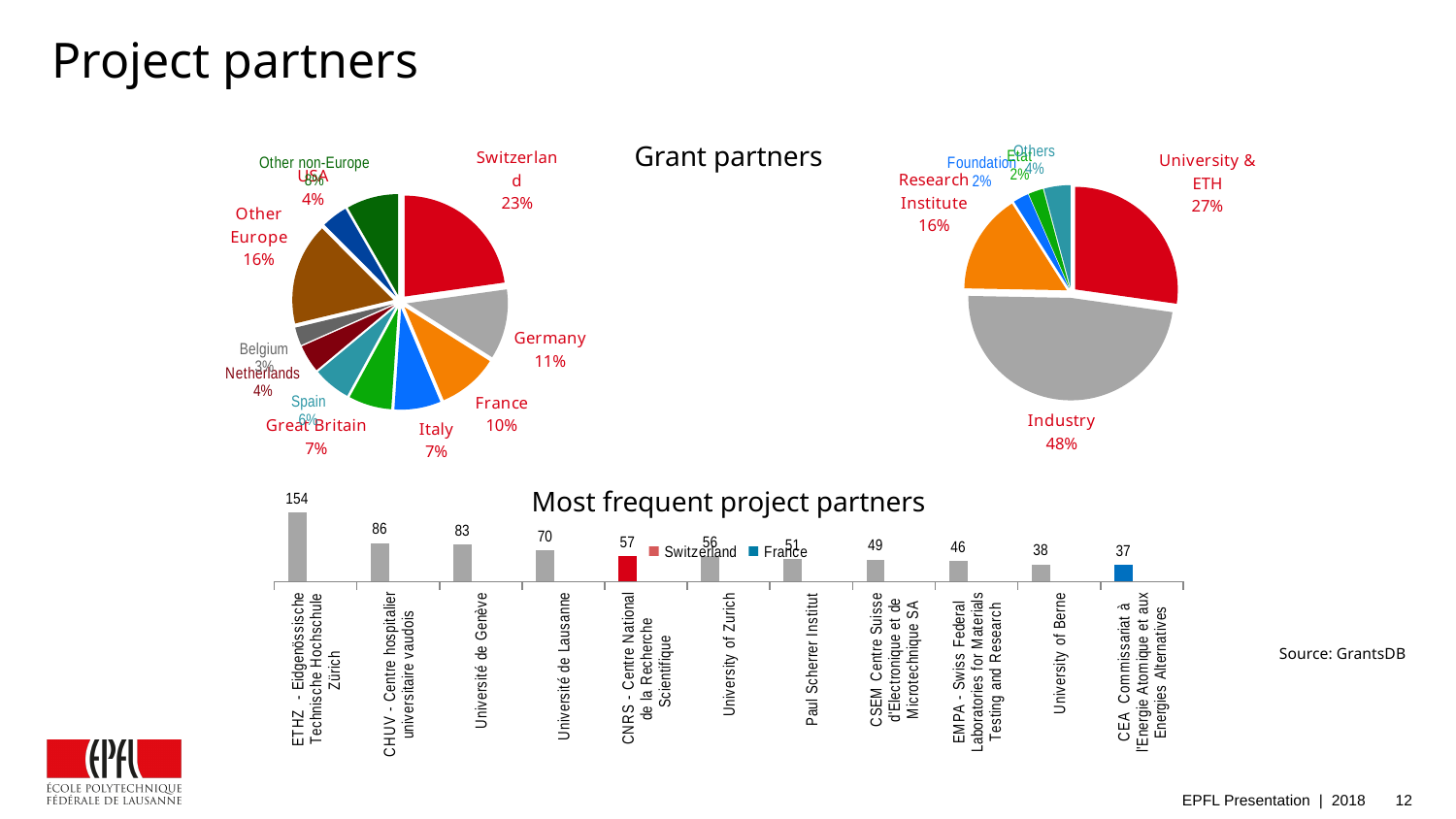
In the bar chart titled 'Most frequent project partners', which partner has the lowest value? CEA Commissariat à l'Energie Atomique et aux Energies Alternatives In the bar chart titled 'Most frequent project partners', what is the value for ETHZ - Eidgenössische Technische Hochschule Zürich? 154 In the pie chart on the right, which category has the largest share? Industry In the bar chart titled 'Most frequent project partners', what is the value for Paul Scherrer Institut? 51 What kind of chart is 'Most frequent project partners'? bar chart In the pie chart on the left, what is the difference between the shares for Other Europe and Spain? 10% In the bar chart titled 'Most frequent project partners', how many series does the legend list? 2 In the bar chart titled 'Most frequent project partners', how many partners are shown? 11 In the bar chart titled 'Most frequent project partners', what is the difference between the values for ETHZ and CHUV - Centre hospitalier universitaire vaudois? 68 In the pie chart on the left, what share does Switzerland have? 23% In the pie chart on the right, what share does Industry have? 48% In the pie chart on the left, which is larger, the share for Germany or the share for France? Germany